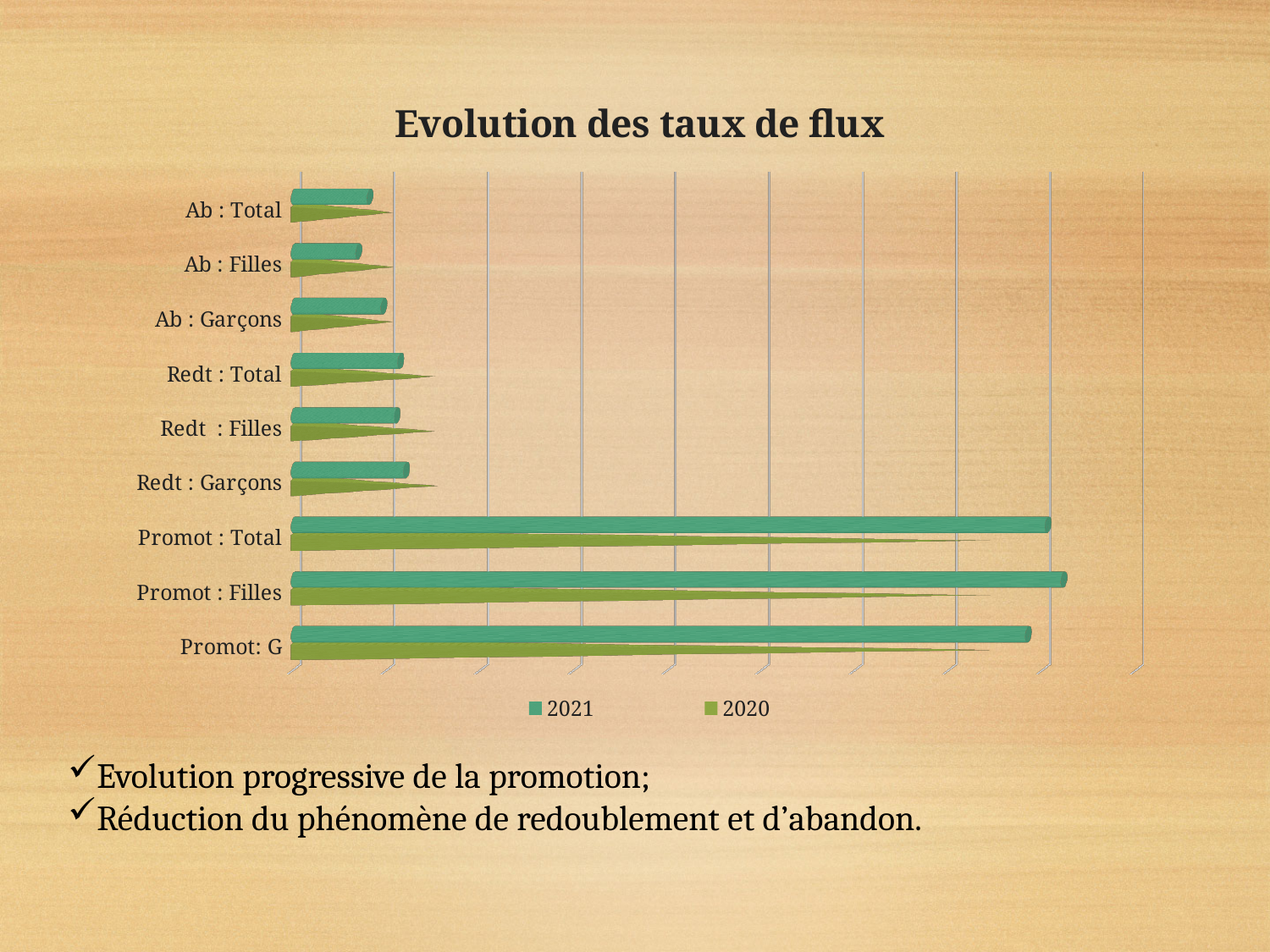
In the 2021 series, which is larger, Redt : Garçons or Ab : Filles? Redt : Garçons What is the title of the chart? Evolution des taux de flux In the 2020 series, which is larger, Ab : Garçons or Promot: G? Promot: G Which years are listed in the chart legend? 2021 and 2020 What kind of chart is shown on the slide? bar chart How many categories are shown on the chart? 9 For Redt : Total, which series has the larger value, 2021 or 2020? 2020 How many series does the legend list? 2